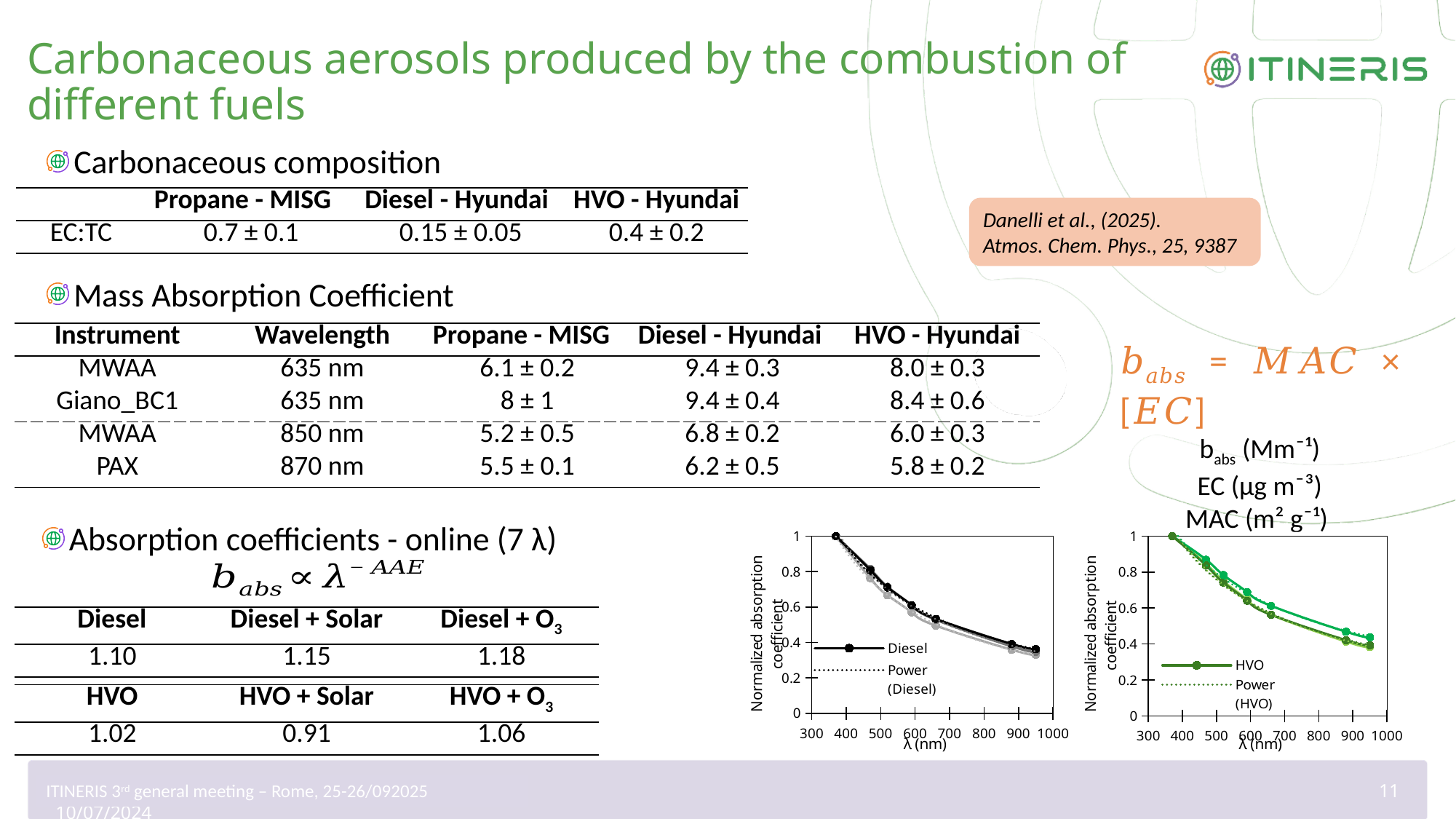
What is the x-axis label of the right chart (HVO)? λ (nm) In the left chart (Diesel), what is the normalized absorption coefficient at the shortest wavelength plotted? 1 How many series does the legend of the left chart (Diesel) list? 2 In the left chart (Diesel), is the Diesel value at around 660 nm greater or less than 0.6? less What is the y-axis label of the left chart (Diesel)? Normalized absorption coefficient How many series does the legend of the right chart (HVO) list? 2 In the right chart (HVO), is the HVO value at around 470 nm greater or less than 0.8? greater In the right chart (HVO), does the normalized absorption coefficient rise or fall as wavelength increases? fall What kind of chart is the left chart (Diesel)? line chart In the left chart (Diesel), is the Diesel value at the longest wavelength (around 950 nm) greater or less than 0.4? less In the left chart (Diesel), does the normalized absorption coefficient rise or fall as wavelength increases? fall What kind of chart is the right chart (HVO)? line chart